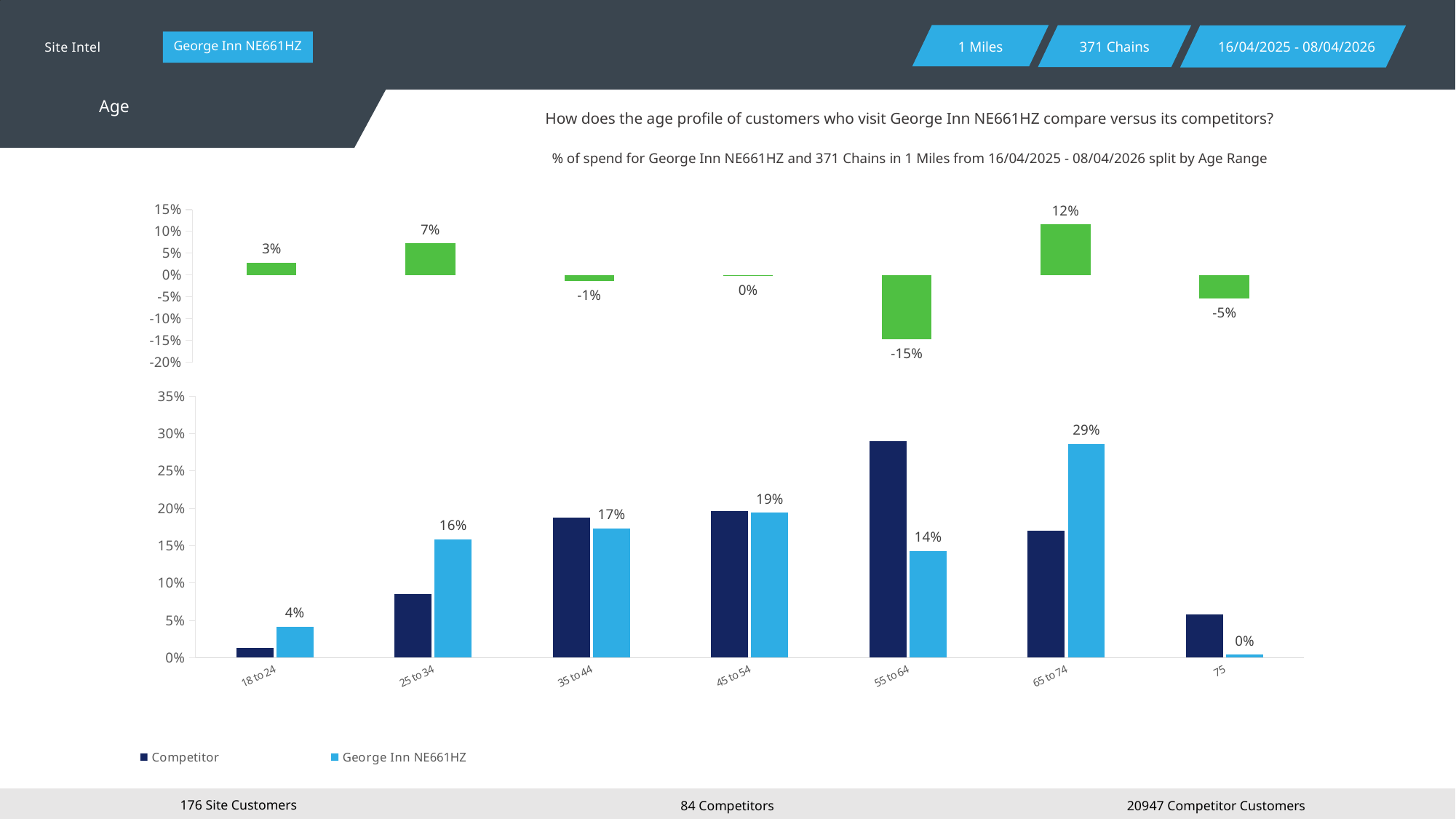
In the top chart, which age range has the lowest value? 55 to 64 How many age range categories are shown in the bottom chart? 7 In the top chart, what is the value shown for the 25 to 34 age range? 7% In the bottom chart, which age range has the highest value for George Inn NE661HZ? 65 to 74 In the top chart, what is the value shown for the 55 to 64 age range? -15% What kind of chart is the bottom chart? bar chart How many series does the legend of the bottom chart list? 2 In the bottom chart, what is the value for George Inn NE661HZ in the 65 to 74 age range? 29% In the bottom chart, what is the difference between the George Inn NE661HZ values for 65 to 74 and 55 to 64? 15 percentage points In the bottom chart, is the Competitor value for 55 to 64 greater or less than 25%? greater In the top chart, which age range has the highest value? 65 to 74 In the bottom chart, for the 55 to 64 age range, which series has the larger value: Competitor or George Inn NE661HZ? Competitor